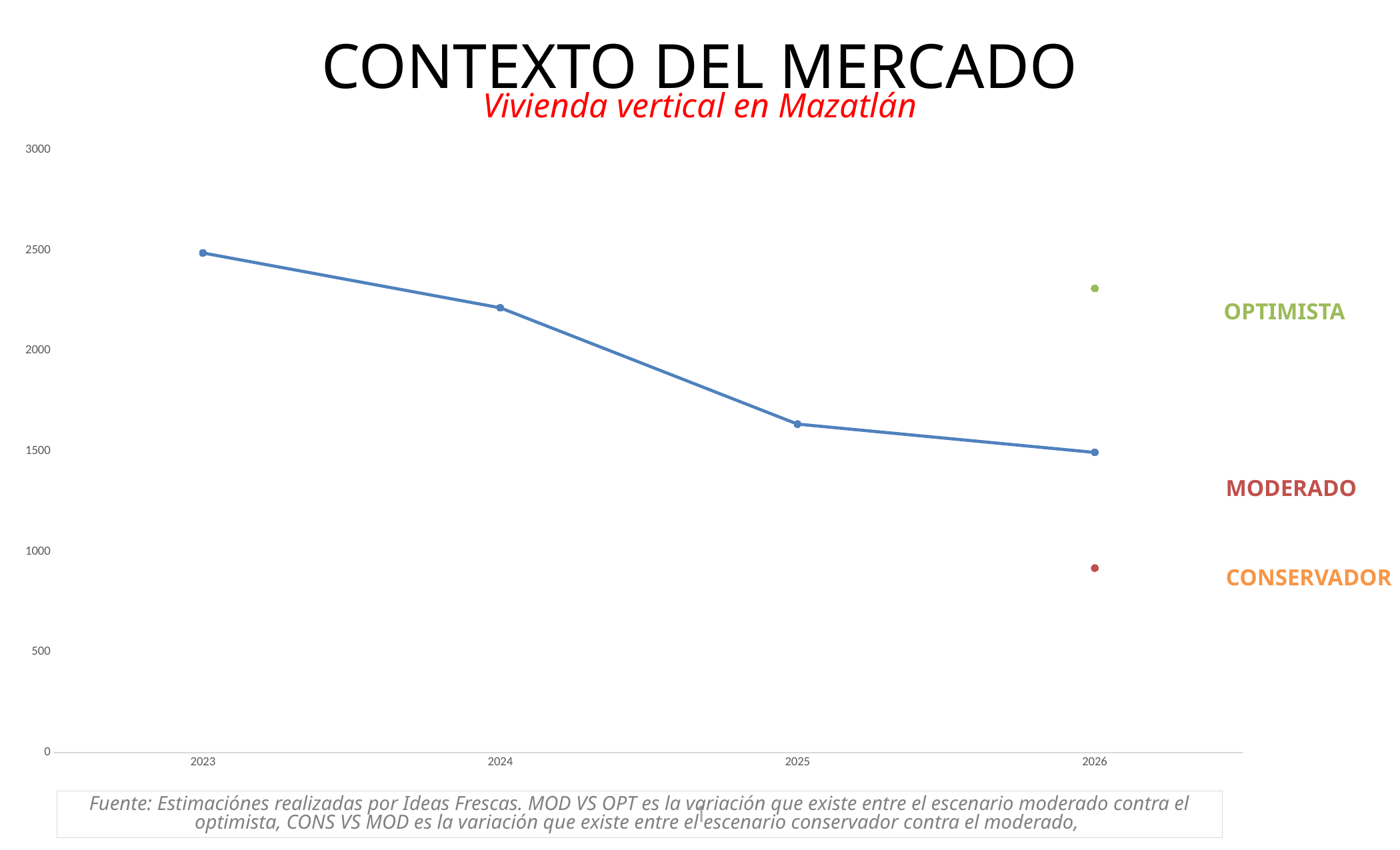
Does the blue line rise or fall from 2023 to 2026? fall In which year does the blue line reach its highest value? 2023 Is the value of the blue line for 2026 greater or less than 1000? greater Is the CONSERVADOR point for 2026 greater or less than 1000? less What kind of chart is shown on the slide? line chart Which is larger in 2026, the OPTIMISTA point or the CONSERVADOR point? OPTIMISTA Is the value of the blue line for 2023 greater or less than 2000? greater In which year does the blue line reach its lowest value? 2026 What is the red subtitle shown under the slide title? Vivienda vertical en Mazatlán How many years are shown on the x axis of the chart? 4